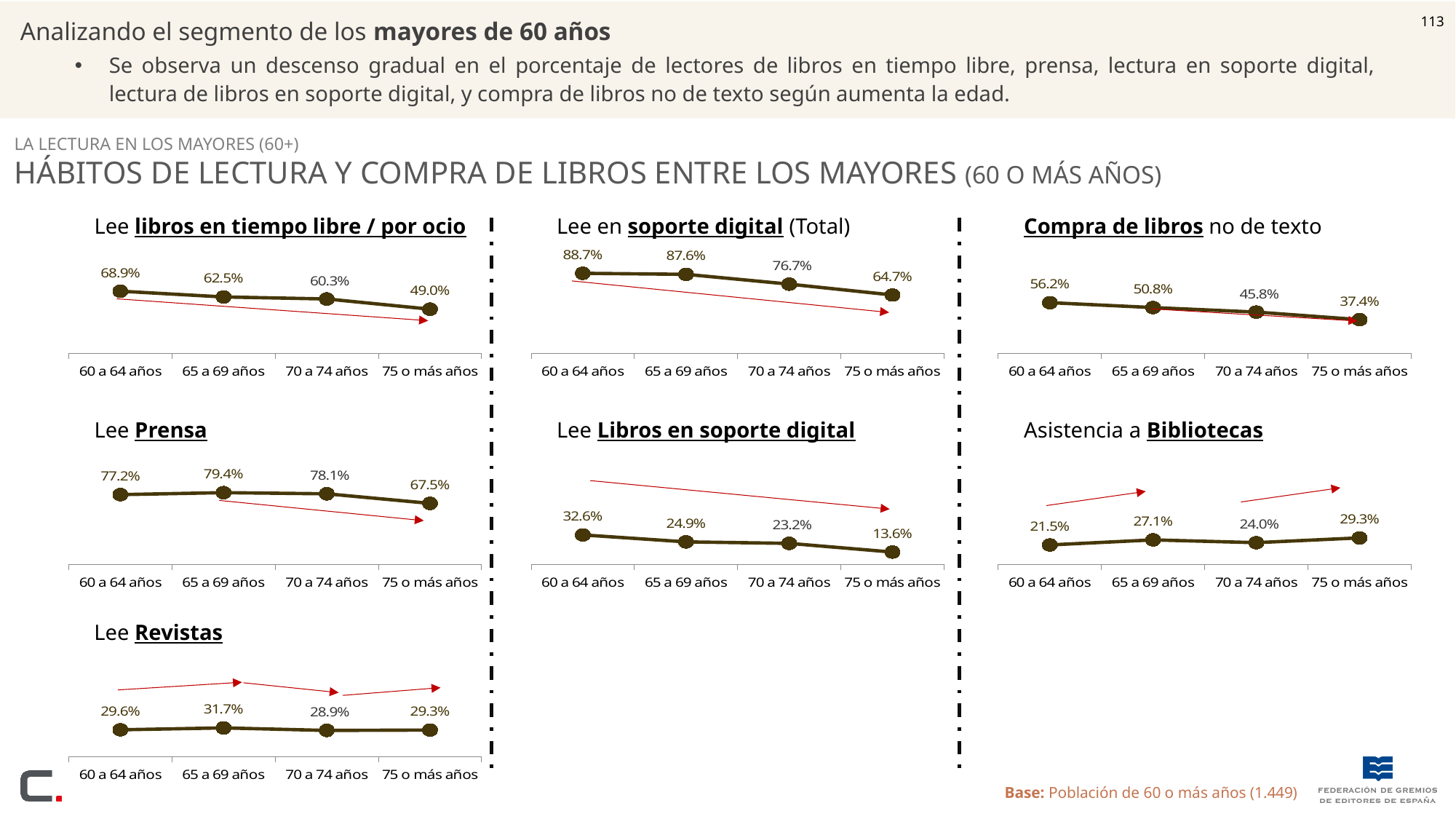
In the 'Compra de libros no de texto' chart, which age group has the lowest value? 75 o más años In the 'Lee libros en tiempo libre / por ocio' chart, what is the value for 60 a 64 años? 68.9% In the 'Lee Libros en soporte digital' chart, what is the difference between the values for 60 a 64 años and 75 o más años? 19.0% How many age groups are shown on the x axis of the 'Lee Prensa' chart? 4 In the 'Lee Revistas' chart, what is the value for 65 a 69 años? 31.7% In the 'Lee Prensa' chart, which age group has the highest value? 65 a 69 años How many charts are shown on the slide? 7 What kind of chart is the 'Compra de libros no de texto' chart? Line chart In the 'Lee en soporte digital (Total)' chart, what is the value for 75 o más años? 64.7% In the 'Lee en soporte digital (Total)' chart, do the values rise or fall from 60 a 64 años to 75 o más años? Fall In the 'Compra de libros no de texto' chart, what is the difference between the values for 60 a 64 años and 65 a 69 años? 5.4% In the 'Asistencia a Bibliotecas' chart, which is larger: the value for 65 a 69 años or 70 a 74 años? 65 a 69 años